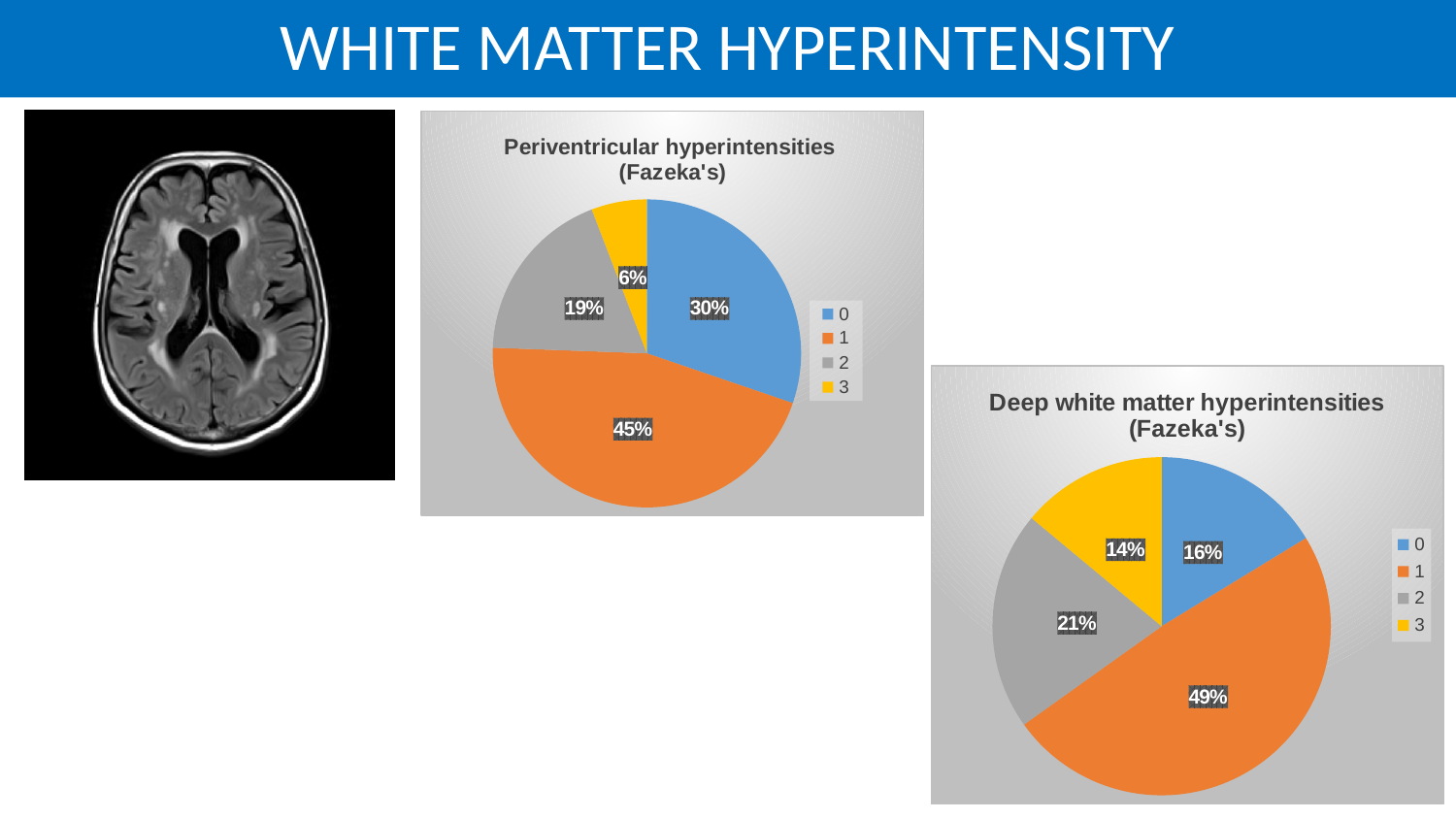
How many categories does the legend of the 'Periventricular hyperintensities (Fazeka's)' chart list? 4 In the 'Deep white matter hyperintensities (Fazeka's)' chart, what percentage is shown for category 0? 16% In the 'Periventricular hyperintensities (Fazeka's)' chart, what percentage is shown for category 3? 6% In the 'Deep white matter hyperintensities (Fazeka's)' chart, which is larger: the slice for category 2 or the slice for category 3? 2 What kind of chart is the 'Deep white matter hyperintensities (Fazeka's)' chart? Pie chart In the 'Deep white matter hyperintensities (Fazeka's)' chart, what share of the pie does category 1 take? 49% In the 'Periventricular hyperintensities (Fazeka's)' chart, what colour is the slice for category 3? Yellow In the 'Periventricular hyperintensities (Fazeka's)' chart, what percentage is shown for category 1? 45% In the 'Periventricular hyperintensities (Fazeka's)' chart, which category has the largest slice? 1 In the 'Periventricular hyperintensities (Fazeka's)' chart, what is the difference between the percentages for category 0 and category 2? 11% In the 'Deep white matter hyperintensities (Fazeka's)' chart, what percentage is shown for category 2? 21% In the 'Deep white matter hyperintensities (Fazeka's)' chart, which category has the smallest slice? 3